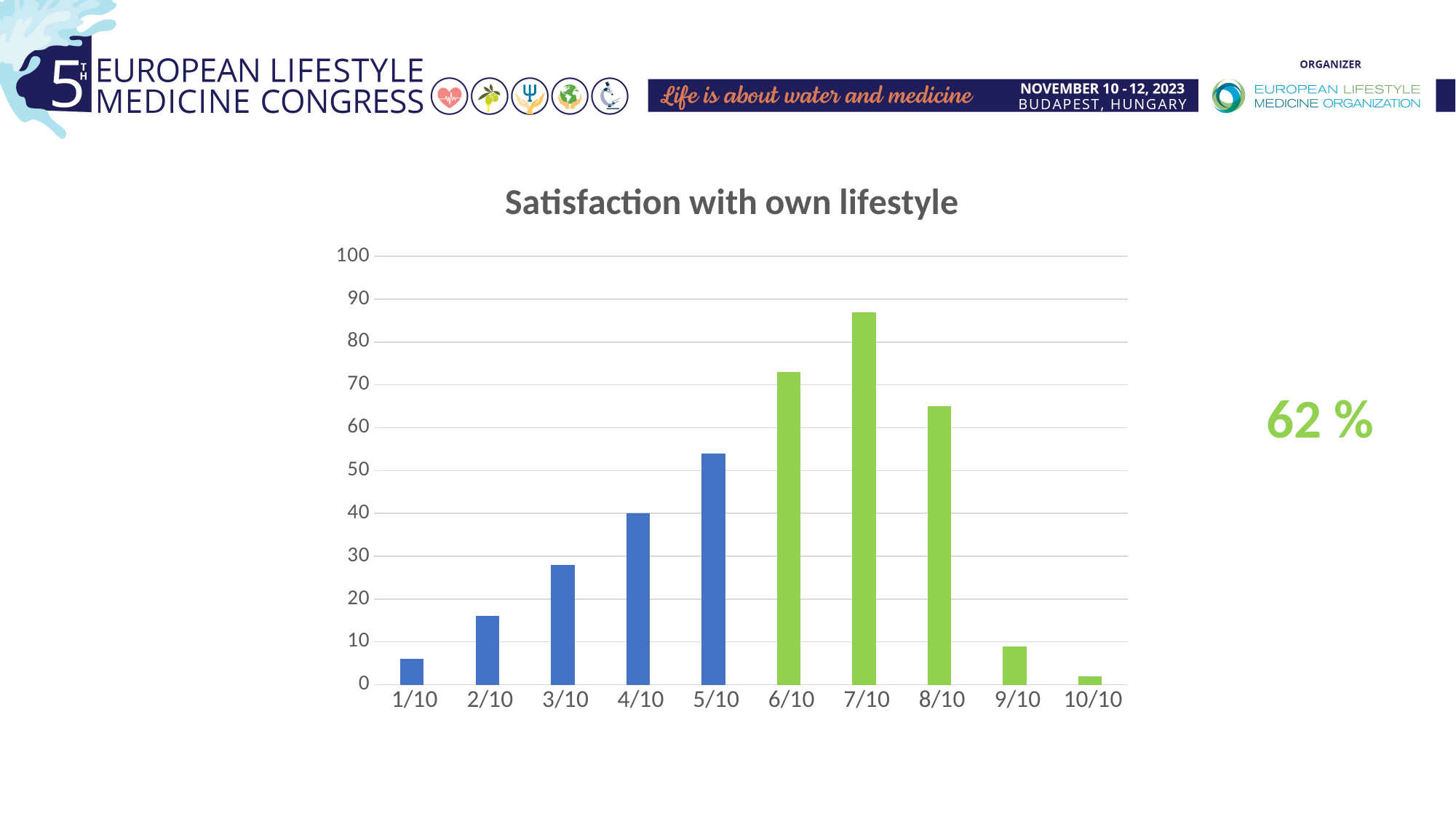
How many categories are shown on the x axis of the chart? 10 Is the value for 8/10 greater or less than 70? less Is the value for 1/10 greater or less than 10? less Is the value for 7/10 greater or less than 80? greater What colour are the bars for 6/10 through 10/10? green What is the title of the chart? Satisfaction with own lifestyle Which category has the lowest bar? 10/10 Which category has the highest bar? 7/10 What kind of chart is shown on the slide? bar chart Which is larger, the value for 6/10 or the value for 8/10? 6/10 Do the values rise or fall from 1/10 to 7/10? rise